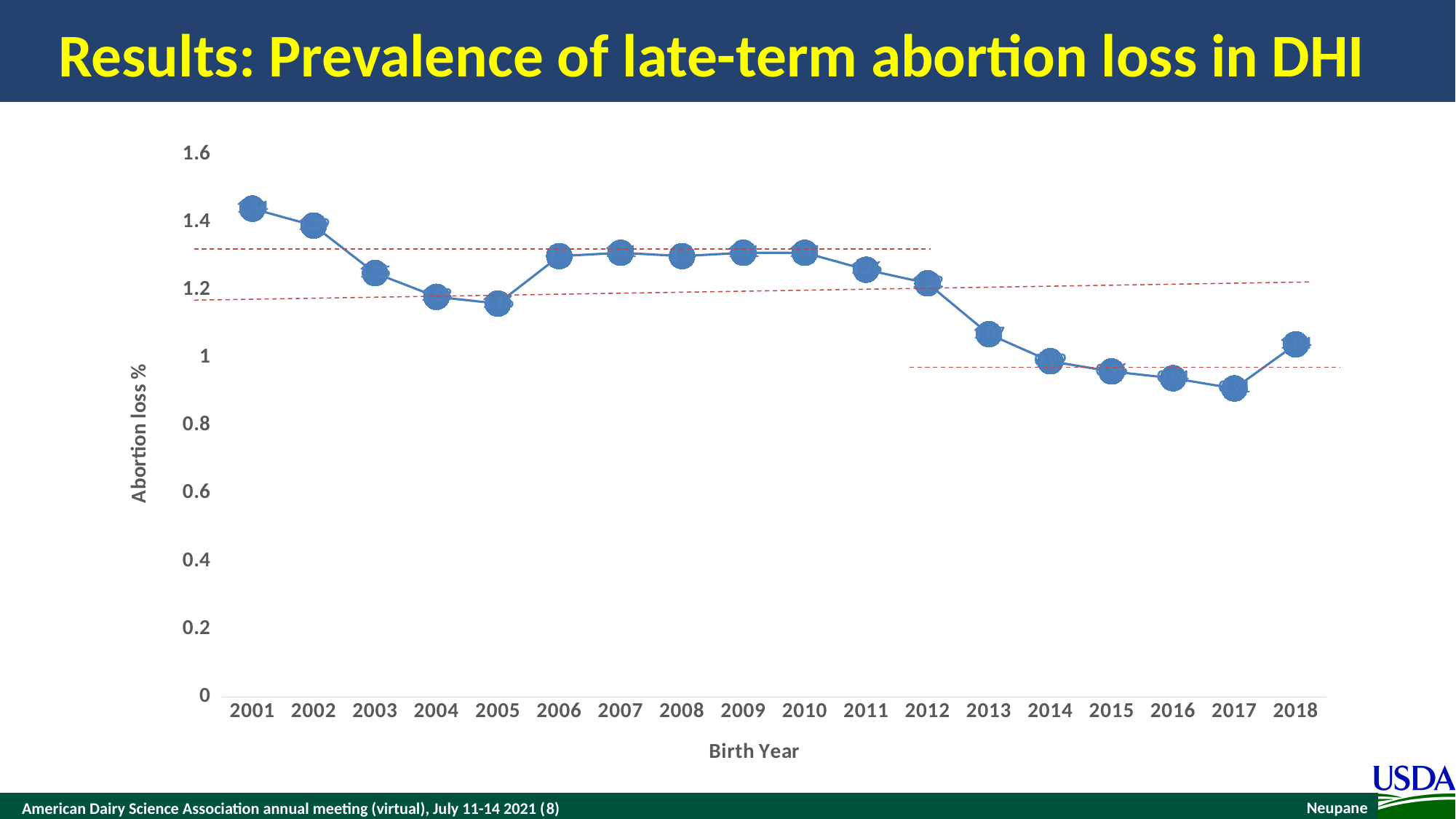
Is the abortion loss % for birth year 2014 greater or less than 1.2? less Is the abortion loss % for birth year 2008 greater or less than 1.2? greater Which birth year has a higher abortion loss %, 2001 or 2018? 2001 What kind of chart is shown on the slide? line chart Overall, does the abortion loss % rise or fall from birth year 2001 to 2017? fall Which birth year has the lowest abortion loss %? 2017 Which birth year has a higher abortion loss %, 2005 or 2006? 2006 How many birth years are plotted on the x axis? 18 Which birth year has the highest abortion loss %? 2001 Is the abortion loss % for birth year 2013 greater or less than 1? greater What is the label of the y axis? Abortion loss %